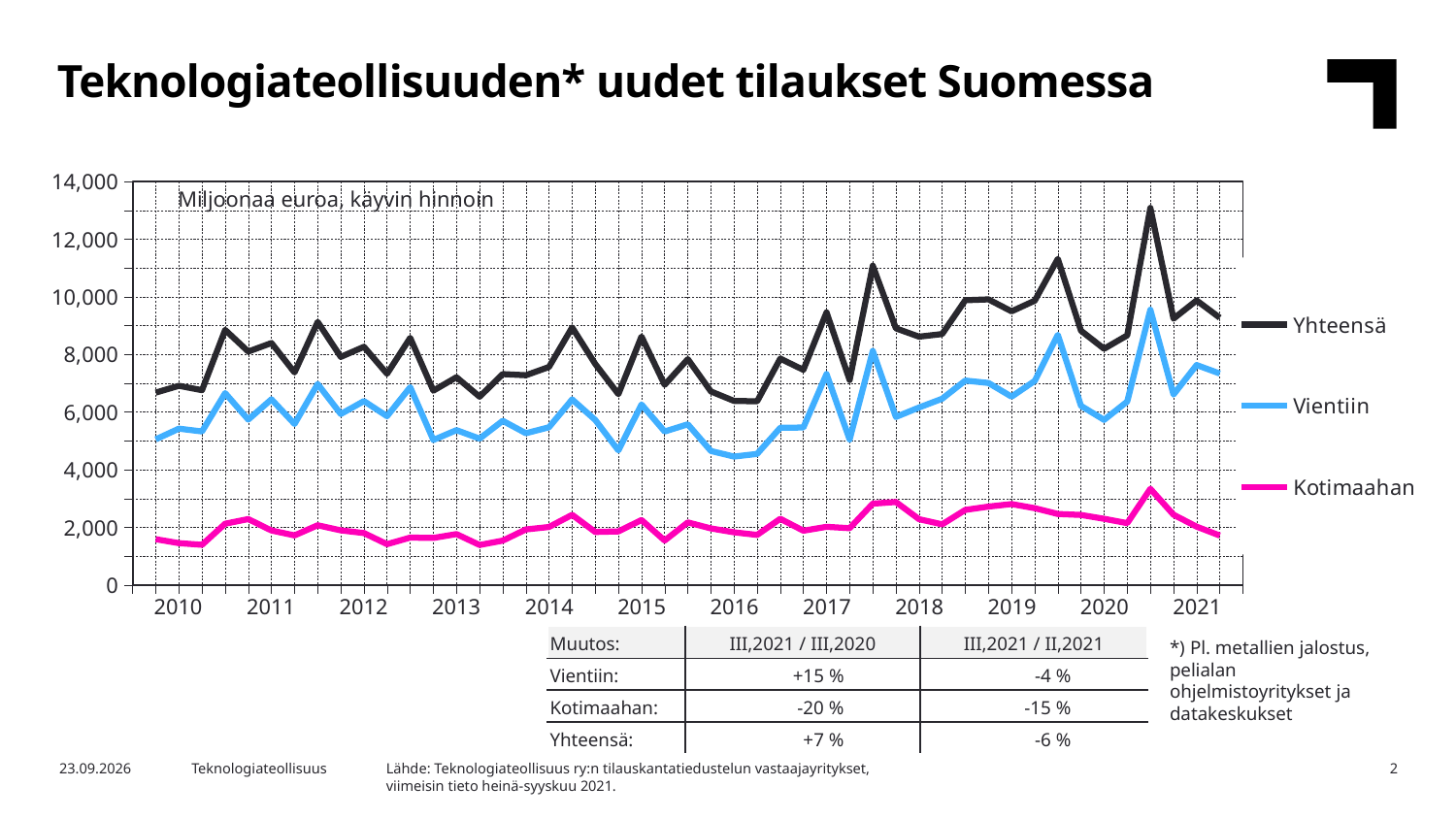
Is the value for Kotimaahan at the start of 2010 greater or less than 4,000? less What are the three series named in the legend? Yhteensä, Vientiin, Kotimaahan How many series does the legend list? 3 Is the peak value of the Vientiin series in 2020 greater or less than 8,000? greater What is the title of the chart on the slide? Teknologiateollisuuden* uudet tilaukset Suomessa Which series has the highest values throughout the chart? Yhteensä What kind of chart is shown on the slide? Line chart Which is larger in 2021, the Vientiin series or the Kotimaahan series? Vientiin Does the Kotimaahan series rise or fall from its 2020 peak to the end of 2021? fall Is the value for Yhteensä at the start of 2010 greater or less than 6,000? greater Which series has the lowest values throughout the chart? Kotimaahan